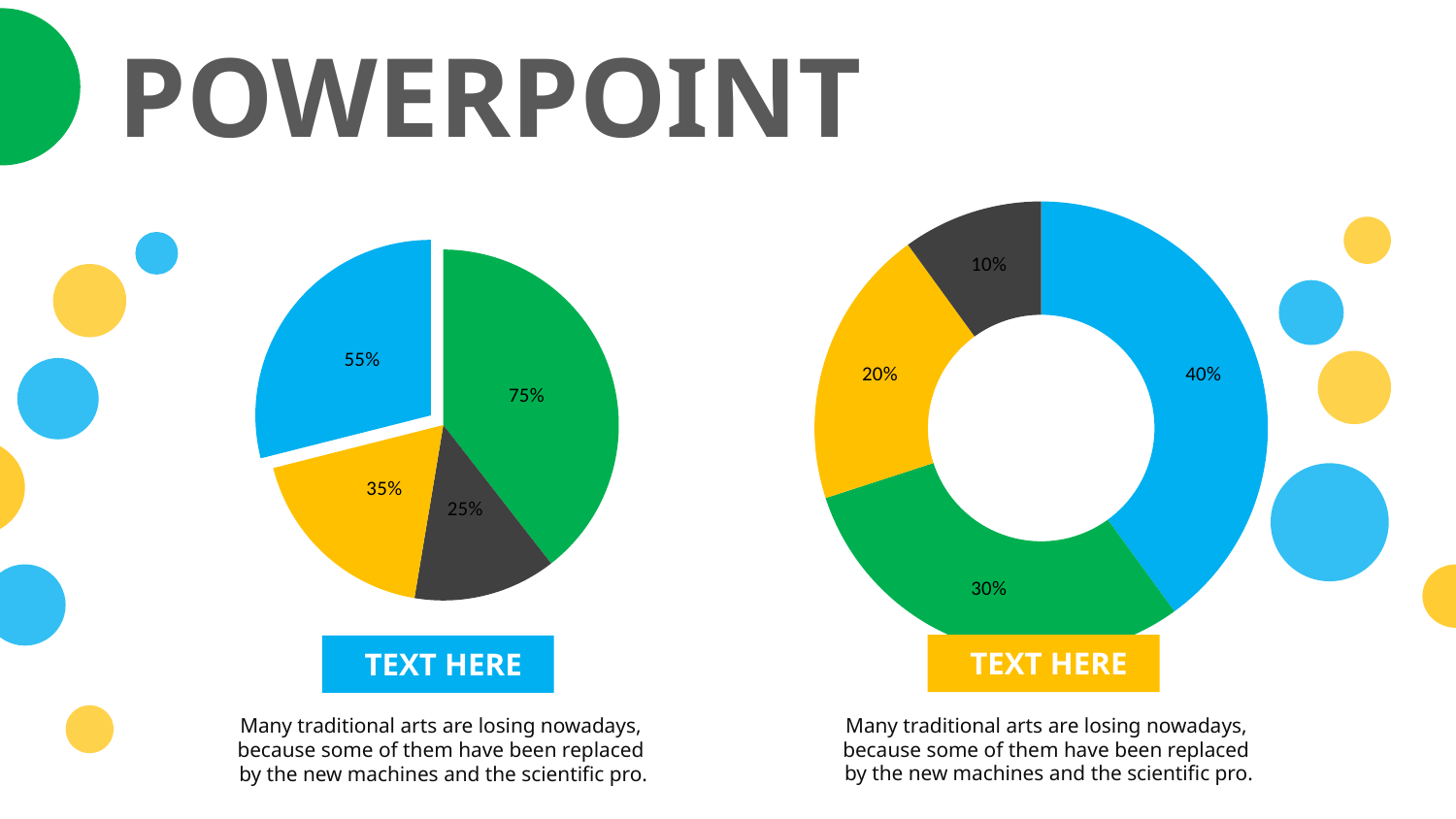
In the pie chart on the left, which slice has the largest value? green (75%) How many slices does the pie chart on the left have? 4 In the pie chart on the left, what value is shown on the dark gray slice? 25% In the doughnut chart on the right, which segment has the smallest value? dark gray (10%) In the pie chart on the left, what is the difference between the green slice and the yellow slice? 40% What type of chart is the chart on the right side of the slide? doughnut chart In the doughnut chart on the right, what is the difference between the blue segment and the dark gray segment? 30% In the pie chart on the left, what value is shown on the blue slice? 55% In the doughnut chart on the right, is the blue segment larger or smaller than the green segment? larger In the doughnut chart on the right, what value is shown on the yellow segment? 20% In the pie chart on the left, what value is shown on the green slice? 75% What type of chart is the chart on the left side of the slide? pie chart